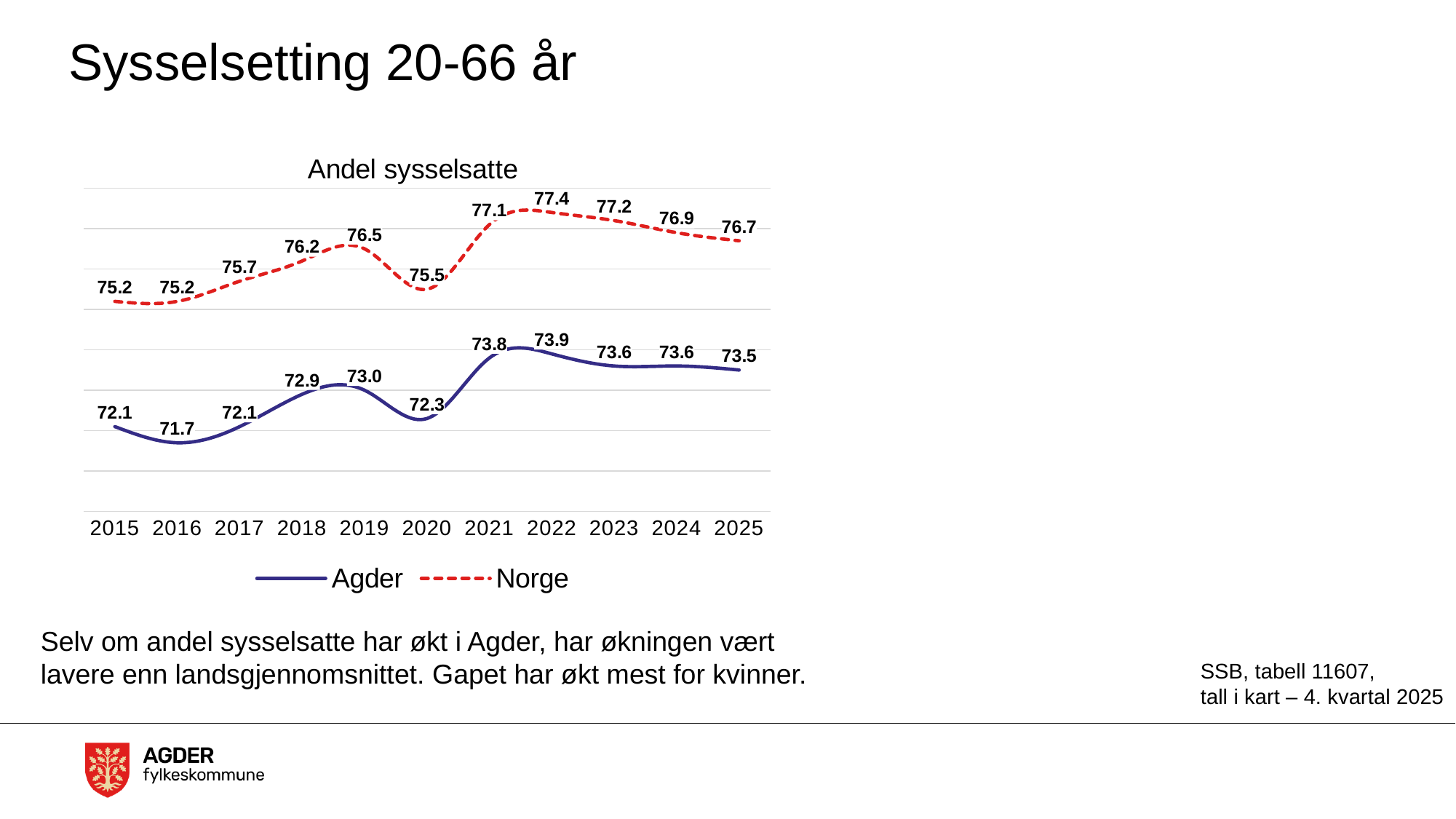
In which year is the Norge series highest? 2022 What is the value for Agder in 2019? 73.0 Which is larger, the Norge value in 2015 or the Norge value in 2020? 2020 What is the difference between the Agder values in 2021 and 2020? 1.5 What is the difference between Norge and Agder in 2025? 3.2 What kind of chart is shown? line chart How many years are shown on the x axis? 11 What is the value for Agder in 2025? 73.5 How many series does the legend list? 2 What is the value for Norge in 2022? 77.4 In which year is the Agder series lowest? 2016 What is the title of the chart? Andel sysselsatte